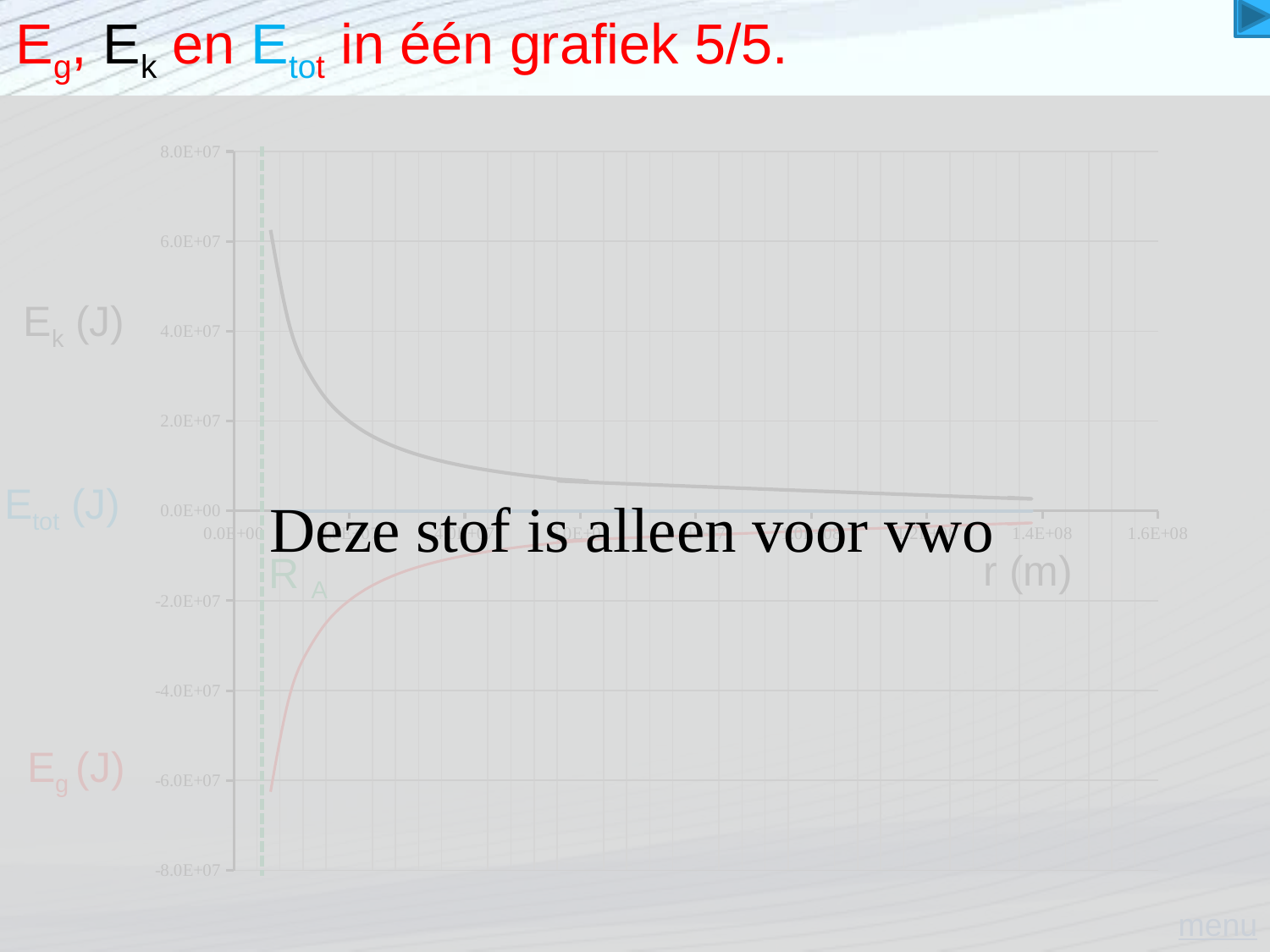
Which curve has the higher value at r = 4.0E+07, Ek or Eg? Ek What is the label of the horizontal axis of the chart? r (m) What is the title of the slide containing the chart? Eg, Ek en Etot in één grafiek 5/5. What is the highest tick value shown on the vertical axis? 8.0E+07 Does the Eg curve rise or fall as r increases? rise How many energy curves are plotted in the chart? 3 Is the value of Ek at r = 1.2E+08 greater or less than 2.0E+07? less Does the Ek curve rise or fall as r increases? fall What kind of chart is shown on the slide? line chart What is the largest tick value shown on the horizontal axis? 1.6E+08 Is the value of Ek at the smallest plotted r greater or less than 4.0E+07? greater Is the value of Eg at the smallest plotted r greater or less than -4.0E+07? less